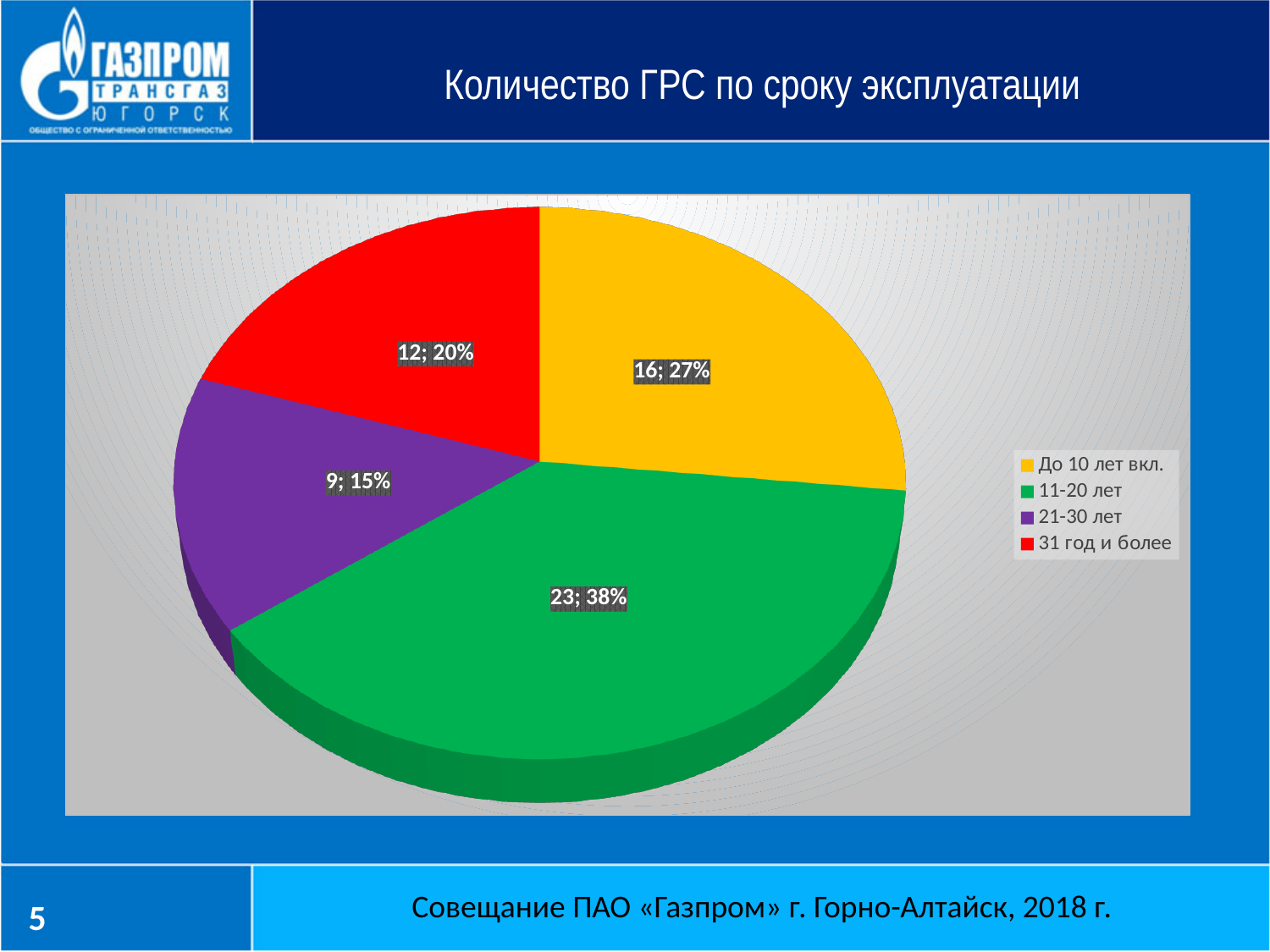
What is the value for the category '31 год и более'? 12 What is the value for the category 'До 10 лет вкл.'? 16 Which category has the smallest share of the pie? 21-30 лет What is the difference between the values for '11-20 лет' and 'До 10 лет вкл.'? 7 What percentage share does the '11-20 лет' slice have? 38% How many categories does the legend list? 4 What is the value for the category '21-30 лет'? 9 What type of chart is shown on the slide? pie chart Which category has the largest share of the pie? 11-20 лет What is the value for the category '11-20 лет'? 23 Which colour represents the '21-30 лет' category? purple What percentage share does the '31 год и более' slice have? 20%